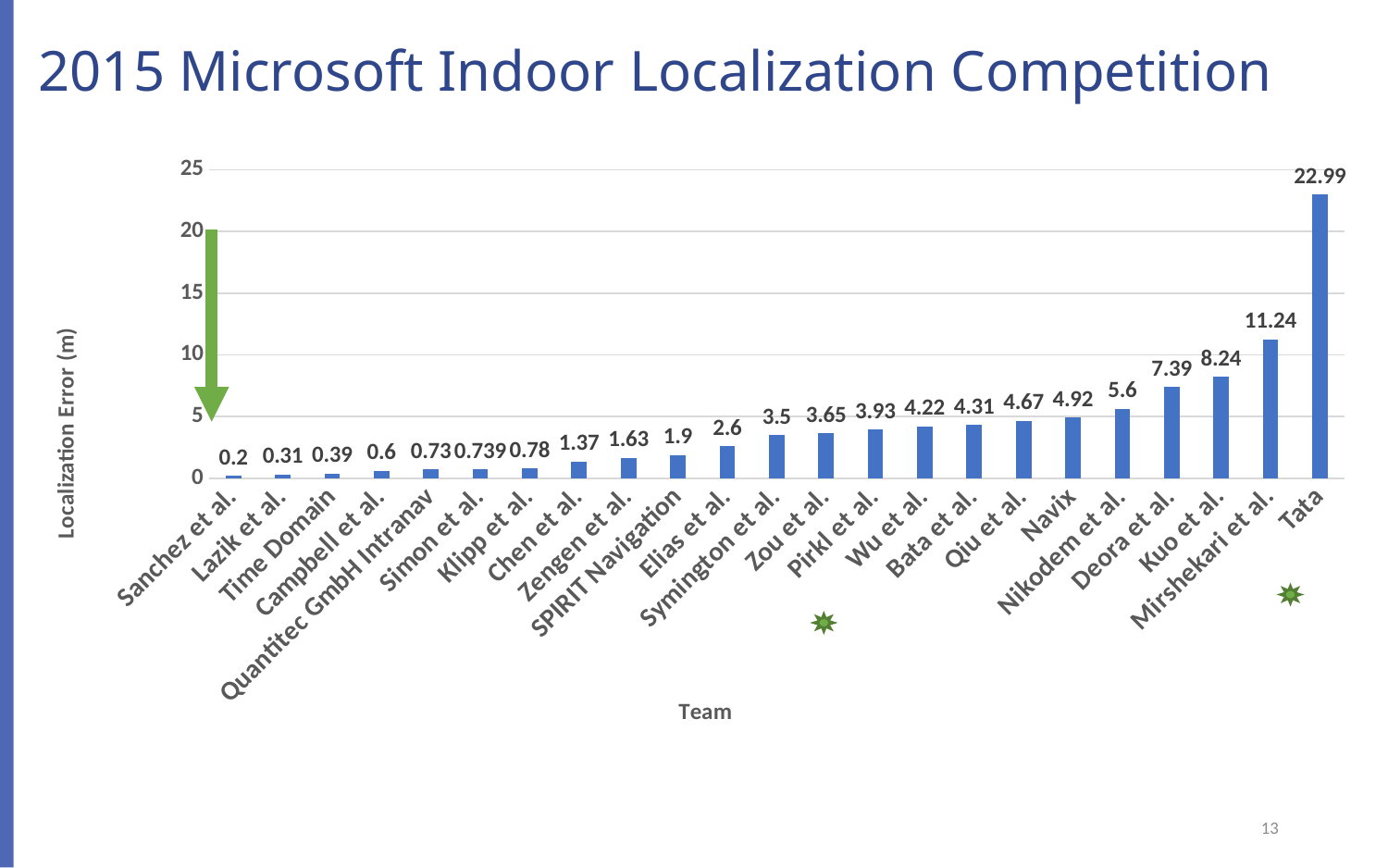
Which team has the highest localization error? Tata How many teams are shown on the x axis? 23 What is the difference in localization error between Tata and Mirshekari et al.? 11.75 What is the localization error for SPIRIT Navigation? 1.9 Do the localization error values rise or fall from left to right along the x axis? Rise Which has a larger localization error, Kuo et al. or Deora et al.? Kuo et al. What is the label of the y axis? Localization Error (m) What kind of chart is shown on the slide? Bar chart What is the localization error for Mirshekari et al.? 11.24 What is the localization error for Time Domain? 0.39 What is the localization error for Tata? 22.99 Which team has the lowest localization error? Sanchez et al.